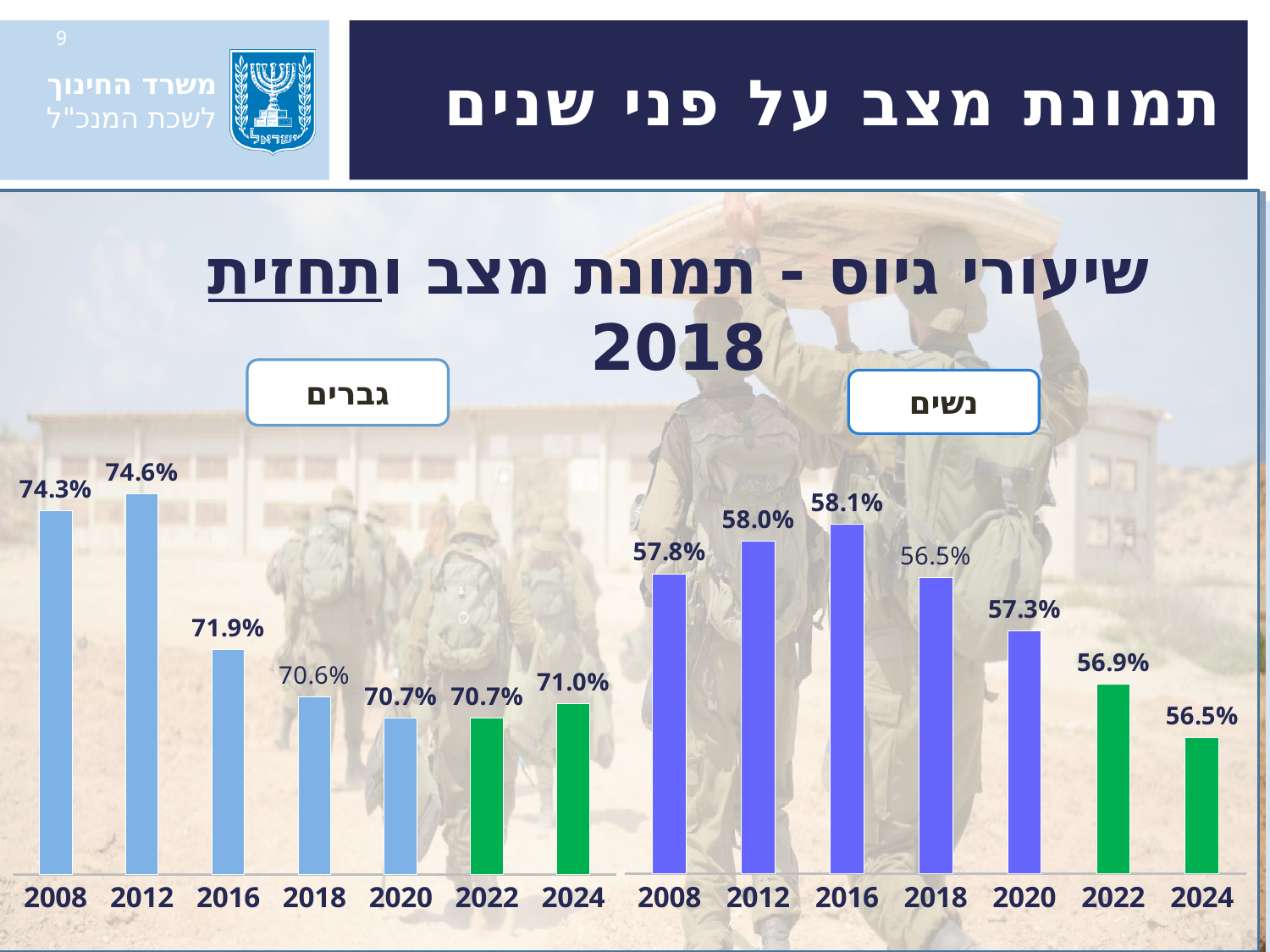
What kind of chart is the נשים chart on the right? bar chart How many years are shown on the x axis of the גברים chart on the left? 7 In the גברים chart on the left, what colour are the bars for 2022 and 2024? green In the גברים chart on the left, which year has the highest value? 2012 In the נשים (women) chart on the right, what is the value for 2020? 57.3% In the גברים chart on the left, do the values rise or fall from 2012 to 2018? fall In the נשים chart on the right, what is the difference between the 2016 value and the 2024 value? 1.6% In the נשים chart on the right, which is larger, the value for 2020 or the value for 2022? 2020 In the נשים chart on the right, which year has the highest value? 2016 In the גברים chart on the left, what is the difference between the 2012 value and the 2024 value? 3.6% In the גברים (men) chart on the left, what is the value for 2012? 74.6%